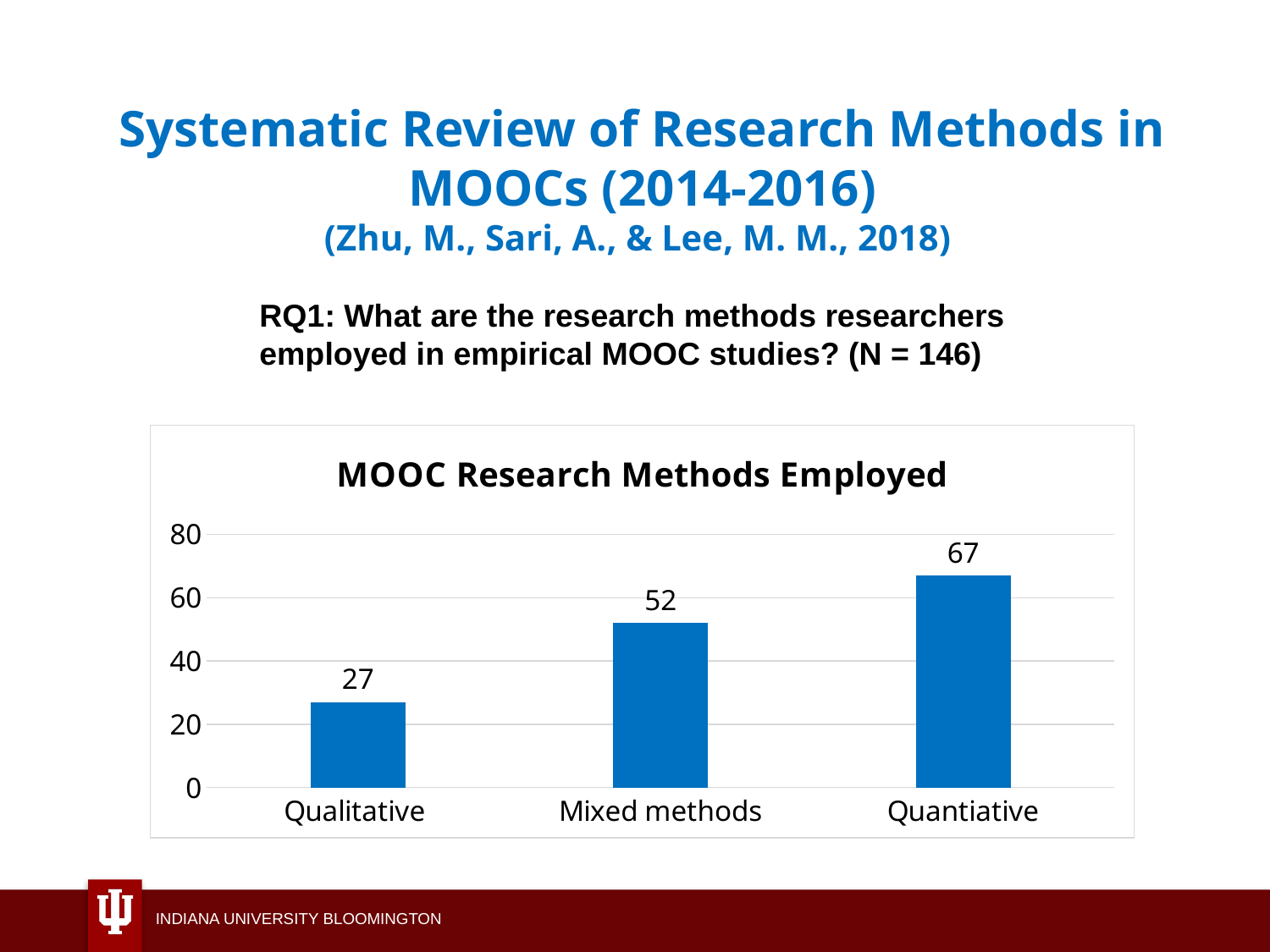
Is the value for Quantiative greater or less than 60? greater How many categories are shown in the chart? 3 What is the difference between the values for Mixed methods and Qualitative? 25 Which is larger, the value for Mixed methods or the value for Qualitative? Mixed methods Which category has the highest value? Quantiative What is the value for Qualitative? 27 What is the difference between the values for Quantiative and Qualitative? 40 What is the value for Quantiative? 67 Which category has the lowest value? Qualitative What is the title of the chart? MOOC Research Methods Employed What is the value for Mixed methods? 52 What kind of chart is shown on the slide? bar chart